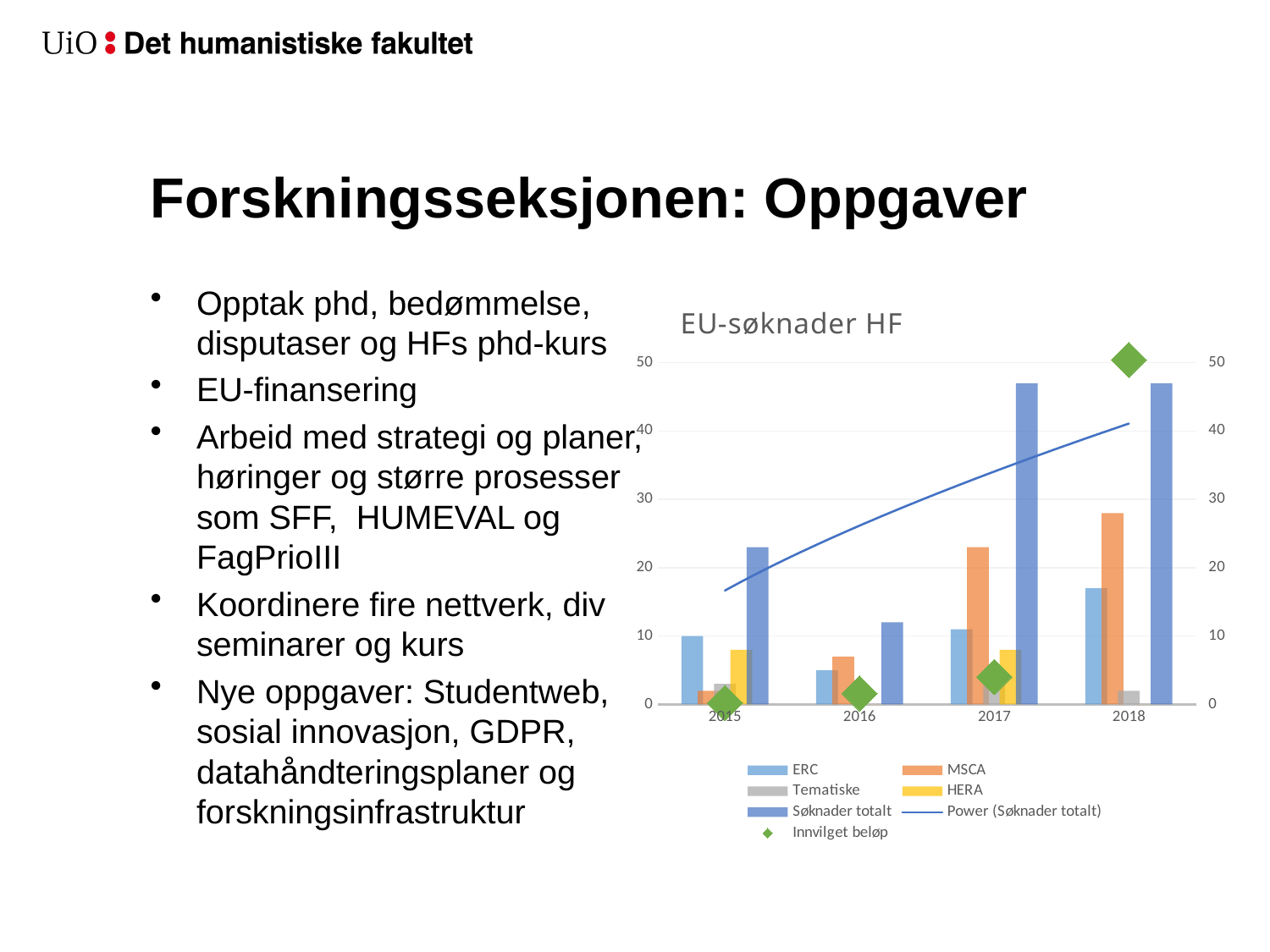
Is the value for Søknader totalt in 2015 greater or less than 20? greater Is the value for Søknader totalt in 2017 greater or less than 40? greater Which is larger: ERC in 2018 or ERC in 2015? ERC in 2018 What is the title of the chart? EU-søknader HF In 2017, which is larger: MSCA or ERC? MSCA Does the Power (Søknader totalt) trend line rise or fall from 2015 to 2018? rise Which year has the lowest value for Søknader totalt? 2016 What kind of chart is shown on the slide? bar chart How many entries does the chart's legend list? 7 Is the value for Søknader totalt in 2016 greater or less than 20? less How many years are shown on the x axis of the chart? 4